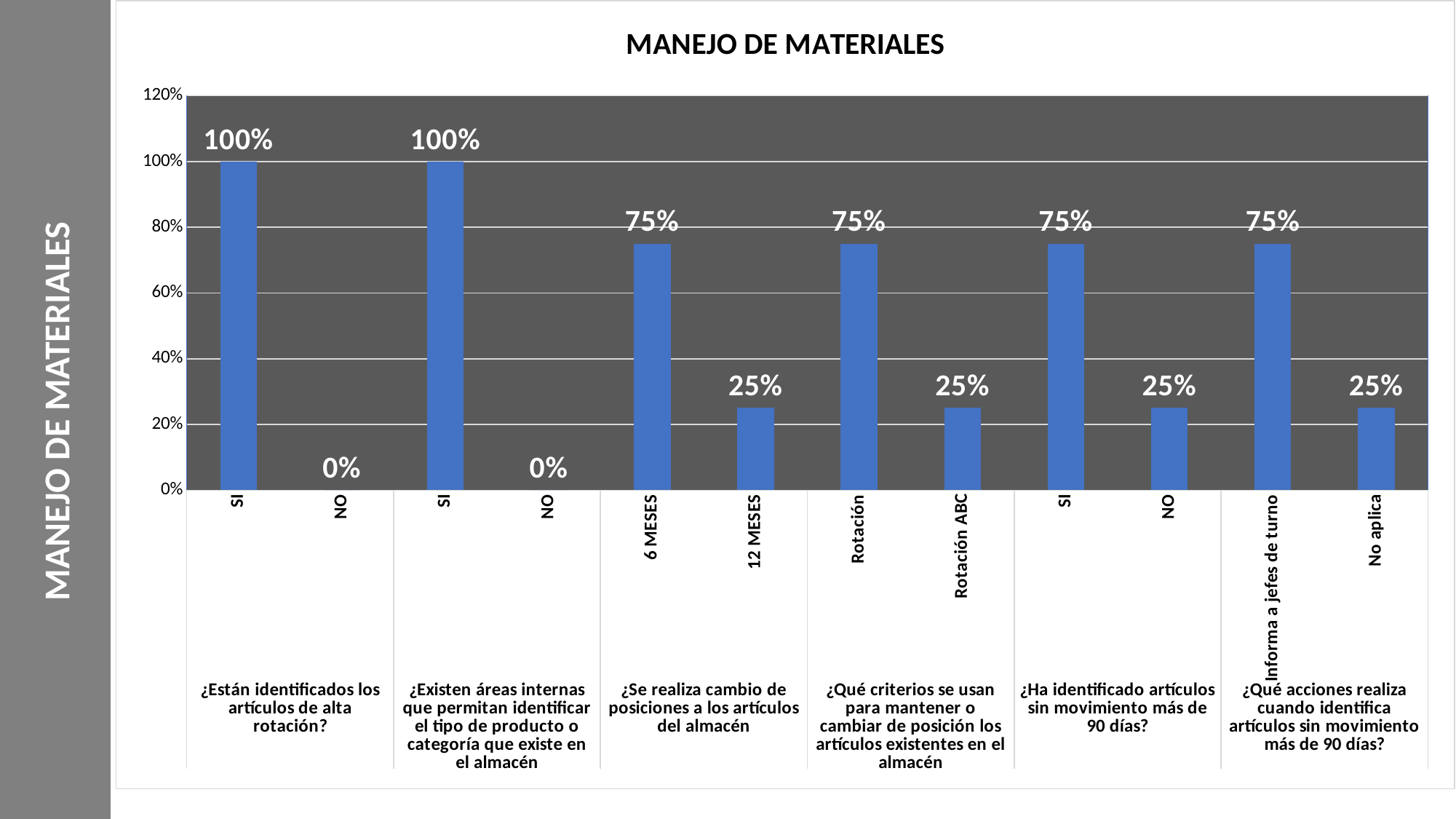
What is the highest value shown in the chart? 100% What is the value for "Informa a jefes de turno" under "¿Qué acciones realiza cuando identifica artículos sin movimiento más de 90 días?"? 75% What type of chart is shown on the slide? Bar chart What is the value for "12 MESES" under "¿Se realiza cambio de posiciones a los artículos del almacén"? 25% What is the value for "NO" under the question "¿Existen áreas internas que permitan identificar el tipo de producto o categoría que existe en el almacén"? 0% What is the value for "SI" under the question "¿Están identificados los artículos de alta rotación?"? 100% What is the title of the chart? MANEJO DE MATERIALES How many bars are plotted in the chart? 12 What is the lowest value shown in the chart? 0% What is the difference between the values for "6 MESES" and "12 MESES"? 50% What is the value for "Rotación" under "¿Qué criterios se usan para mantener o cambiar de posición los artículos existentes en el almacén"? 75% Which is larger: the value for "SI" or "NO" under "¿Ha identificado artículos sin movimiento más de 90 días?"? SI